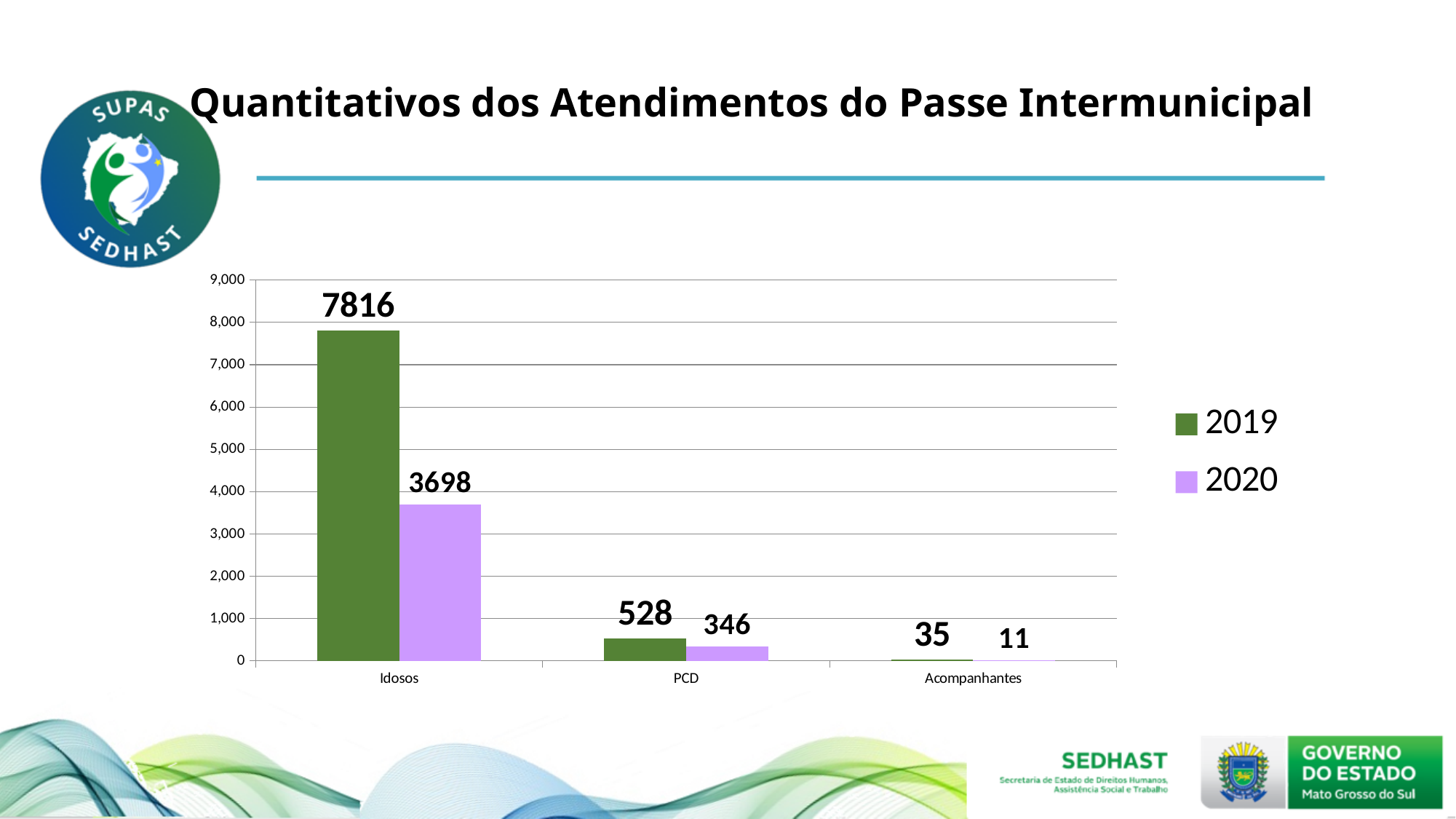
Is the 2020 value for Idosos greater or less than 4,000? less What is the value for PCD in 2020? 346 How many series does the legend list? 2 Which category has the lowest value in 2019? Acompanhantes What is the value for Idosos in 2019? 7816 How many categories are shown on the x axis? 3 Which category has the highest value in 2020? Idosos What is the difference between the 2019 and 2020 values for PCD? 182 Which is larger, the 2019 value for PCD or the 2020 value for PCD? 2019 value for PCD What is the difference between the 2019 and 2020 values for Idosos? 4118 What kind of chart is shown on the slide? bar chart What is the value for Acompanhantes in 2019? 35